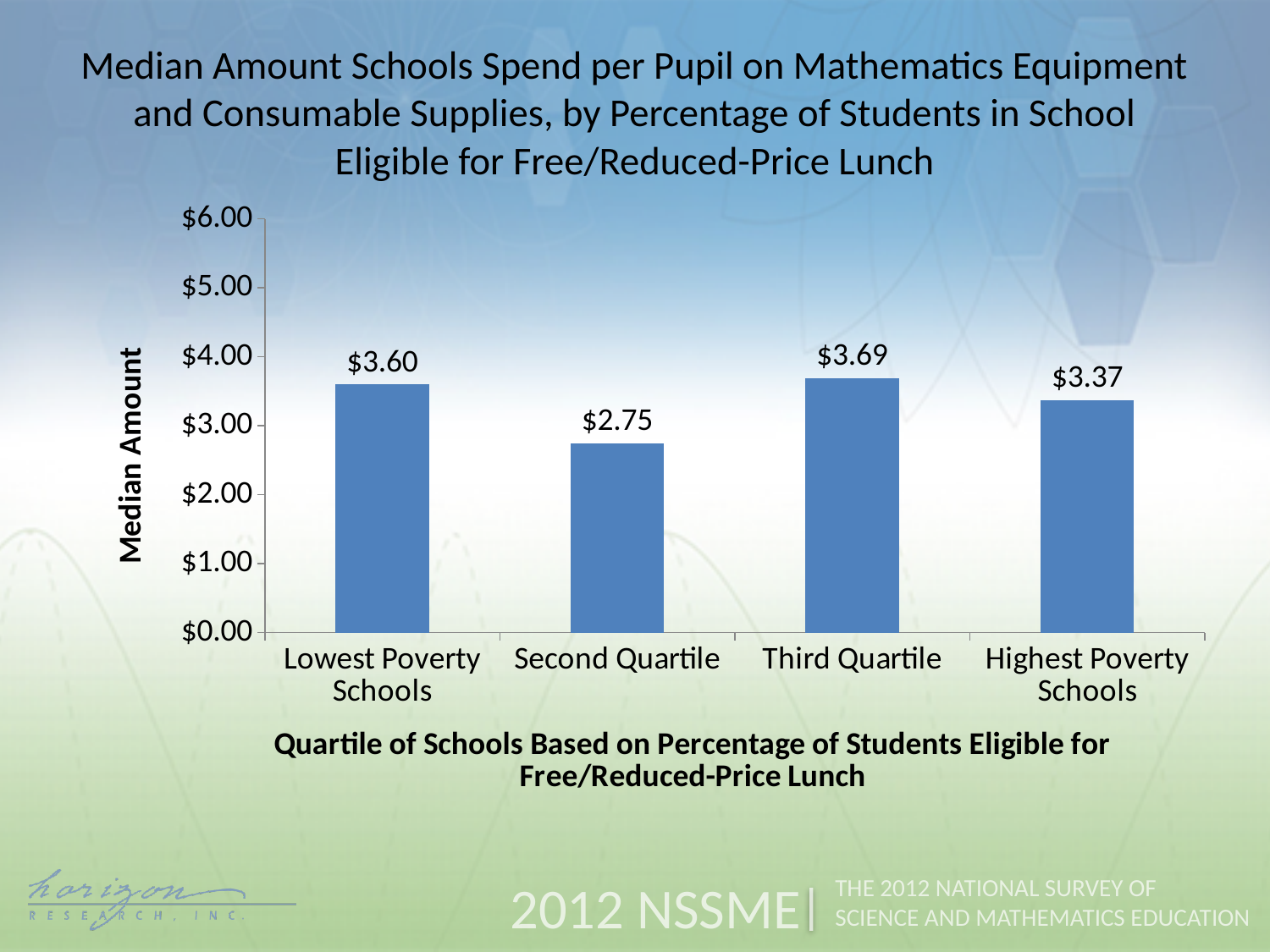
Is the value for the Second Quartile greater or less than $3.00? less Which has a larger median amount, Lowest Poverty Schools or Highest Poverty Schools? Lowest Poverty Schools What kind of chart is shown on the slide? Bar chart What is the median amount spent per pupil for the Third Quartile? $3.69 What is the difference between the median amounts for Lowest Poverty Schools and Highest Poverty Schools? $0.23 What is the median amount spent per pupil for the Second Quartile? $2.75 What is the difference between the median amounts for the Third Quartile and the Second Quartile? $0.94 What is the median amount spent per pupil for Highest Poverty Schools? $3.37 Which quartile has the highest median amount spent per pupil? Third Quartile What is the median amount spent per pupil for Lowest Poverty Schools? $3.60 How many quartile categories are shown on the chart? 4 Which quartile has the lowest median amount spent per pupil? Second Quartile